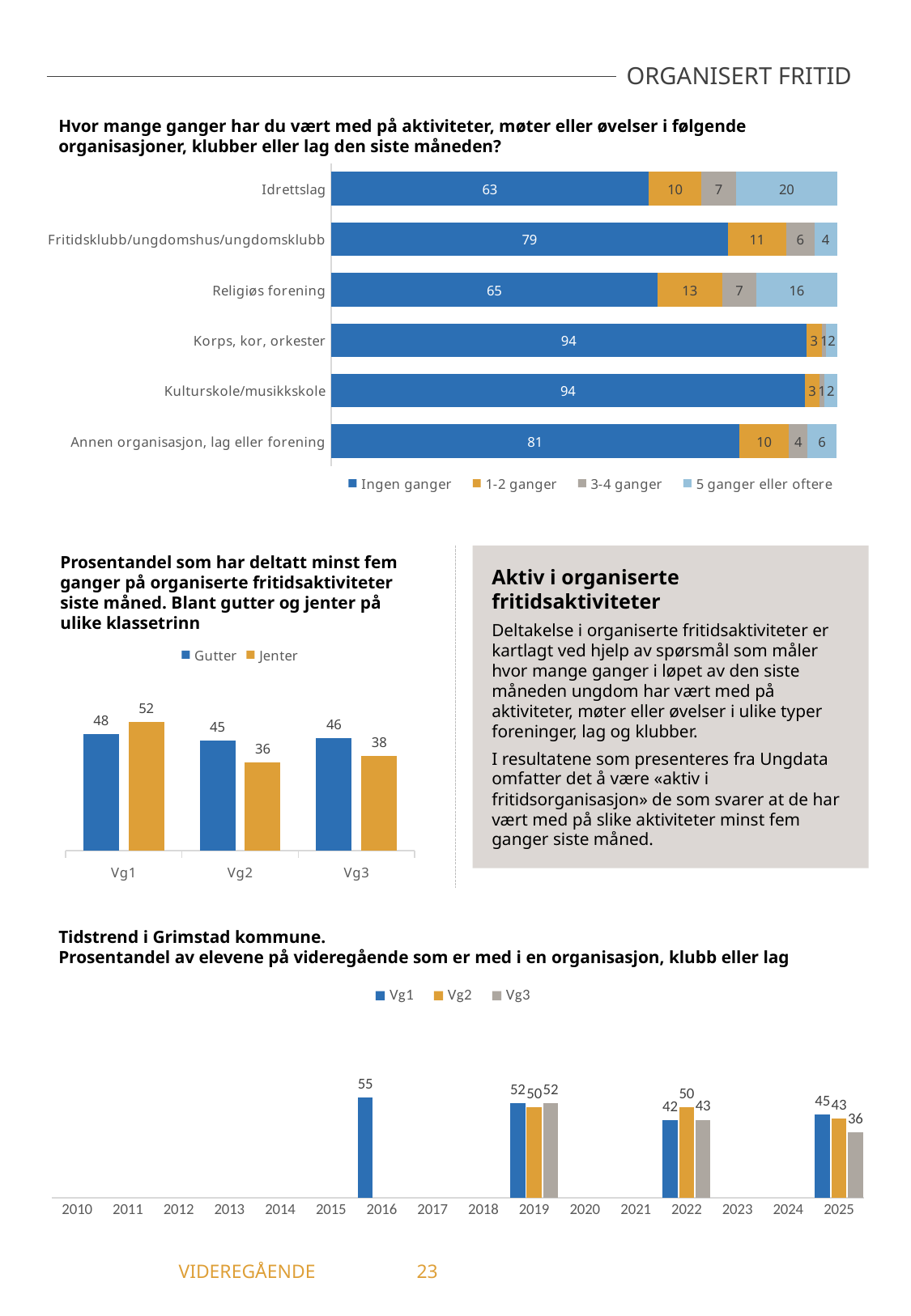
In the top chart 'Hvor mange ganger har du vært med på aktiviteter...', how many series does the legend list? 4 In the top chart 'Hvor mange ganger har du vært med på aktiviteter...', which category has the highest value for '5 ganger eller oftere'? Idrettslag In the bottom chart 'Tidstrend i Grimstad kommune', what is the value for Vg1 in 2016? 55 In the top chart 'Hvor mange ganger har du vært med på aktiviteter...', what is the difference between the 'Ingen ganger' values for Annen organisasjon, lag eller forening and Idrettslag? 18 In the top chart 'Hvor mange ganger har du vært med på aktiviteter...', what is the value for '5 ganger eller oftere' for Religiøs forening? 16 In the bottom chart 'Tidstrend i Grimstad kommune', which series has the lowest value in 2025? Vg3 In the top chart 'Hvor mange ganger har du vært med på aktiviteter...', what is the value for 'Ingen ganger' for Idrettslag? 63 In the middle-left chart 'Prosentandel som har deltatt minst fem ganger...', what is the difference between Gutter and Jenter at Vg3? 8 In the top chart 'Hvor mange ganger har du vært med på aktiviteter...', how many categories are shown? 6 In the middle-left chart 'Prosentandel som har deltatt minst fem ganger...', which is larger at Vg1, Gutter or Jenter? Jenter What kind of chart is the bottom chart 'Tidstrend i Grimstad kommune'? Bar chart In the middle-left chart 'Prosentandel som har deltatt minst fem ganger...', what is the value for Jenter at Vg2? 36